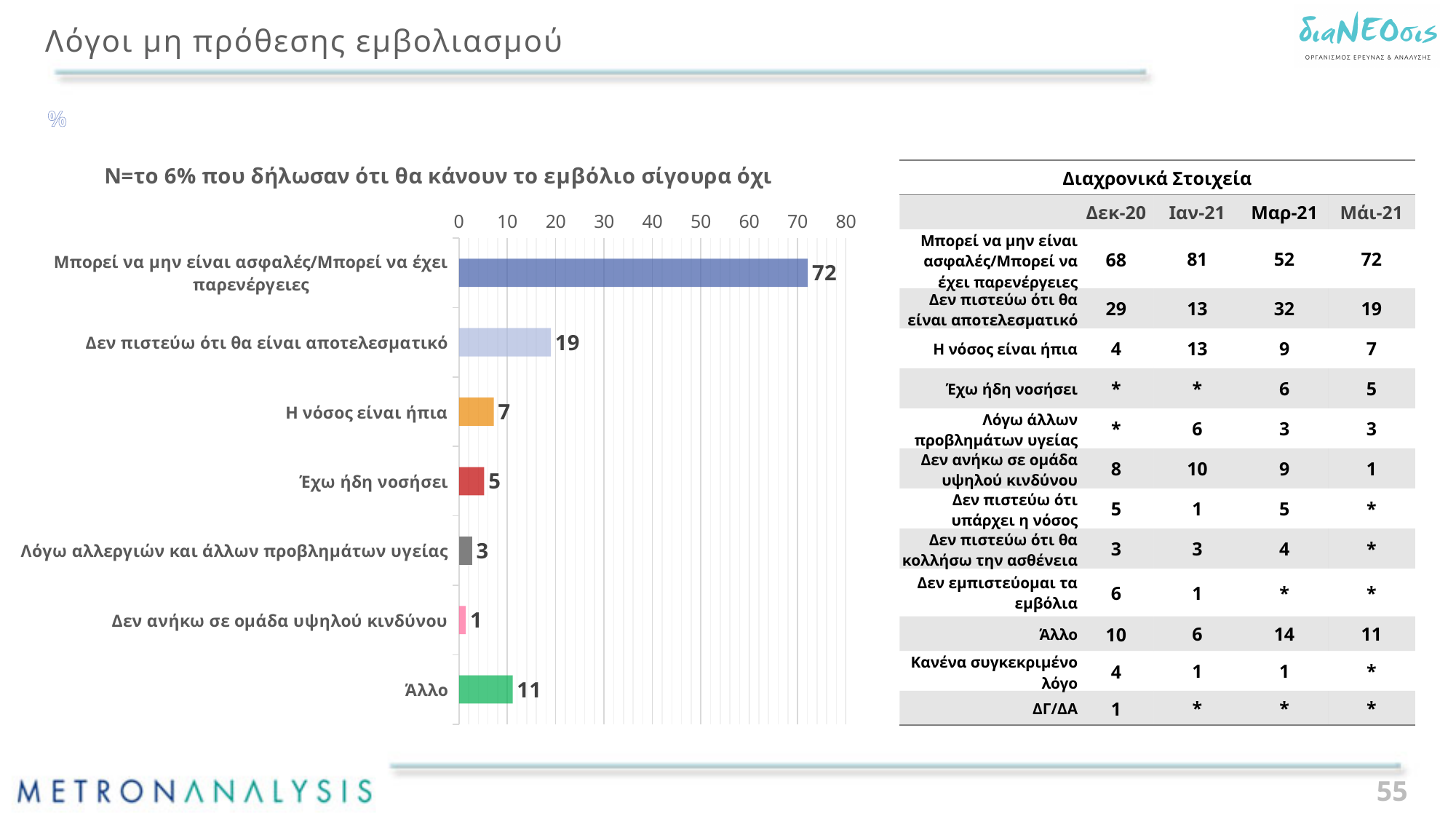
Which is larger in the bar chart: "Άλλο" or "Η νόσος είναι ήπια"? Άλλο What is the value for "Δεν πιστεύω ότι θα είναι αποτελεσματικό" in the bar chart? 19 Is the value for "Μπορεί να μην είναι ασφαλές/Μπορεί να έχει παρενέργειες" greater or less than 70? greater What is the value for "Έχω ήδη νοσήσει" in the bar chart? 5 What is the value for "Άλλο" in the bar chart? 11 What is the difference between the values for "Μπορεί να μην είναι ασφαλές/Μπορεί να έχει παρενέργειες" and "Δεν πιστεύω ότι θα είναι αποτελεσματικό"? 53 What kind of chart is shown on the left of the slide? bar chart Which category has the highest value in the bar chart? Μπορεί να μην είναι ασφαλές/Μπορεί να έχει παρενέργειες How many categories are shown in the bar chart? 7 Which category has the lowest value in the bar chart? Δεν ανήκω σε ομάδα υψηλού κινδύνου What is the subtitle printed above the bar chart? N=το 6% που δήλωσαν ότι θα κάνουν το εμβόλιο σίγουρα όχι What is the difference between the values for "Άλλο" and "Η νόσος είναι ήπια"? 4